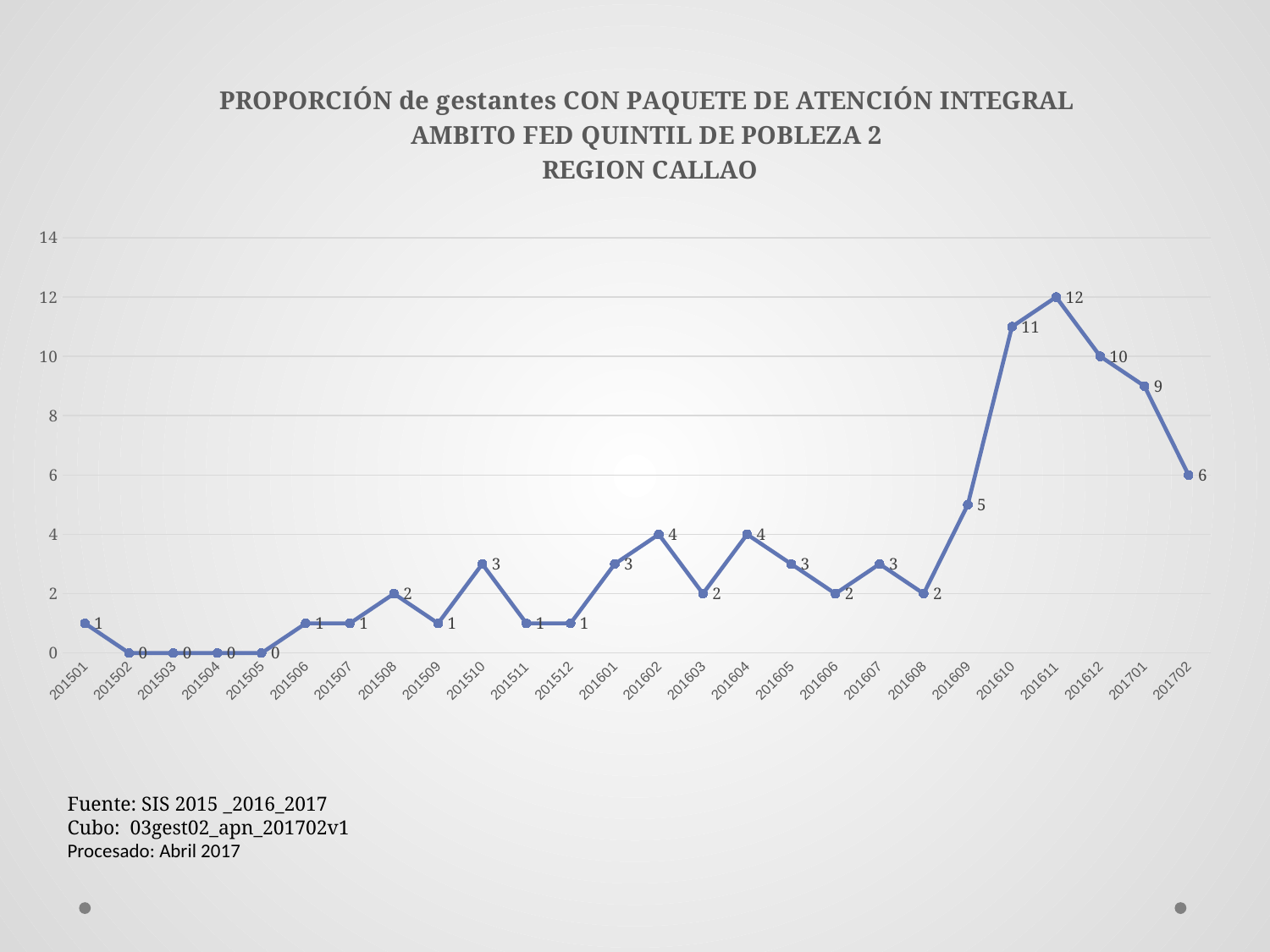
Which region is named in the chart title? REGION CALLAO What is the value for 201611? 12 What is the value for 201702? 6 Which period has the highest value? 201611 Do the values rise or fall from 201611 to 201702? fall Is the value for 201701 greater or less than 8? greater What is the difference between the values for 201611 and 201610? 1 What is the difference between the values for 201612 and 201702? 4 What type of chart is shown on the slide? line chart What is the value for 201609? 5 How many periods are plotted on the x axis? 26 Which is larger, the value for 201602 or the value for 201603? 201602